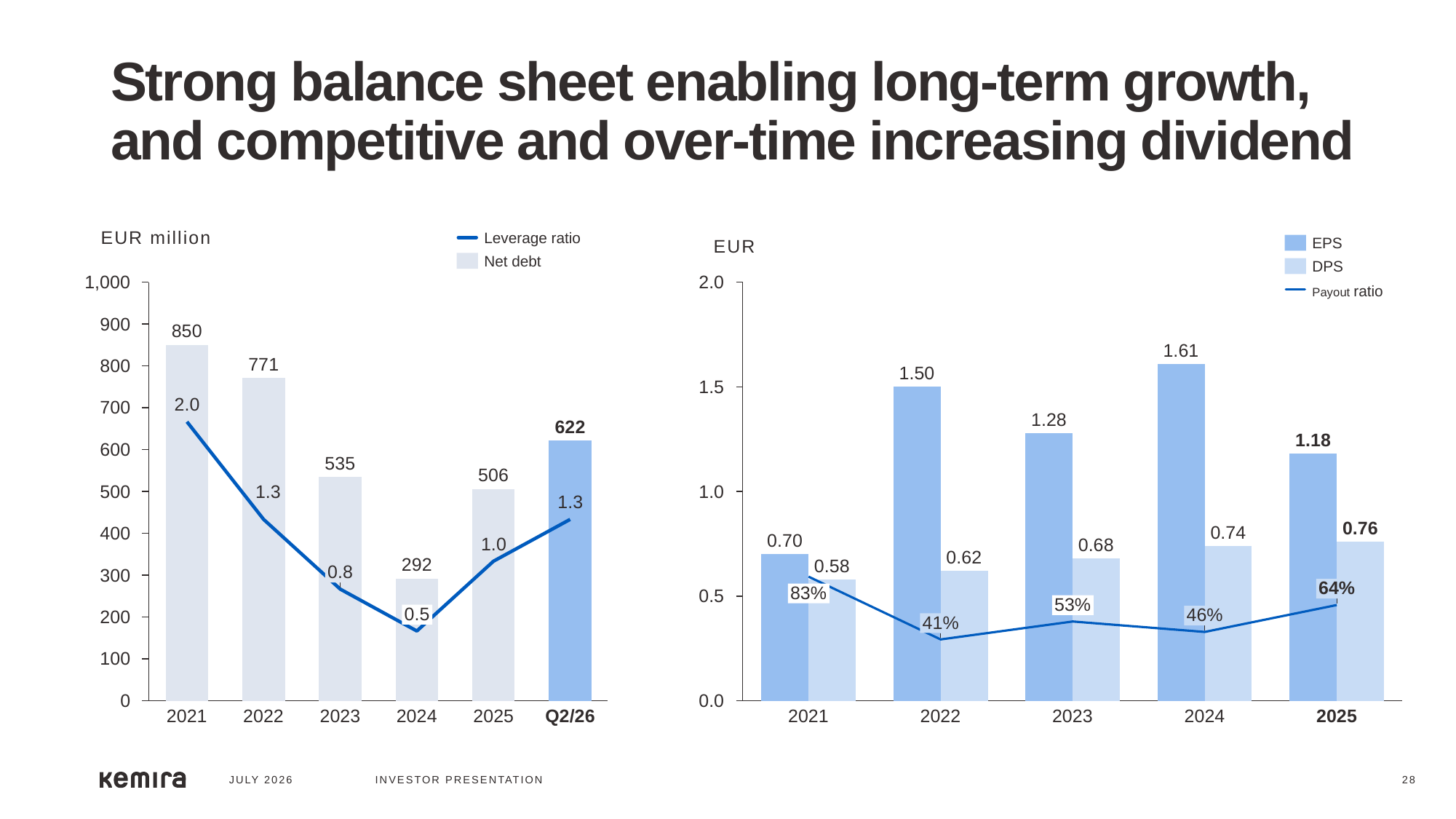
In the right chart (EPS, DPS and Payout ratio), how many series does the legend list? 3 In the left chart (Net debt and Leverage ratio), what is the leverage ratio for 2024? 0.5 In the left chart (Net debt and Leverage ratio), which year has the lowest net debt? 2024 In the right chart (EPS, DPS and Payout ratio), is the EPS for 2021 larger or smaller than the EPS for 2025? smaller In the right chart (EPS, DPS and Payout ratio), what is the payout ratio for 2022? 41% In the left chart (Net debt and Leverage ratio), does net debt rise or fall from 2021 to 2024? fall In the left chart (Net debt and Leverage ratio), what is the difference in net debt between 2022 and 2023? 236 In the left chart (Net debt and Leverage ratio), how many periods are shown on the x axis? 6 In the right chart (EPS, DPS and Payout ratio), what is the difference between EPS and DPS in 2023? 0.60 In the right chart (EPS, DPS and Payout ratio), which year has the highest DPS? 2025 In the left chart (Net debt and Leverage ratio), what is the net debt for 2021? 850 In the right chart (EPS, DPS and Payout ratio), what is the EPS for 2024? 1.61